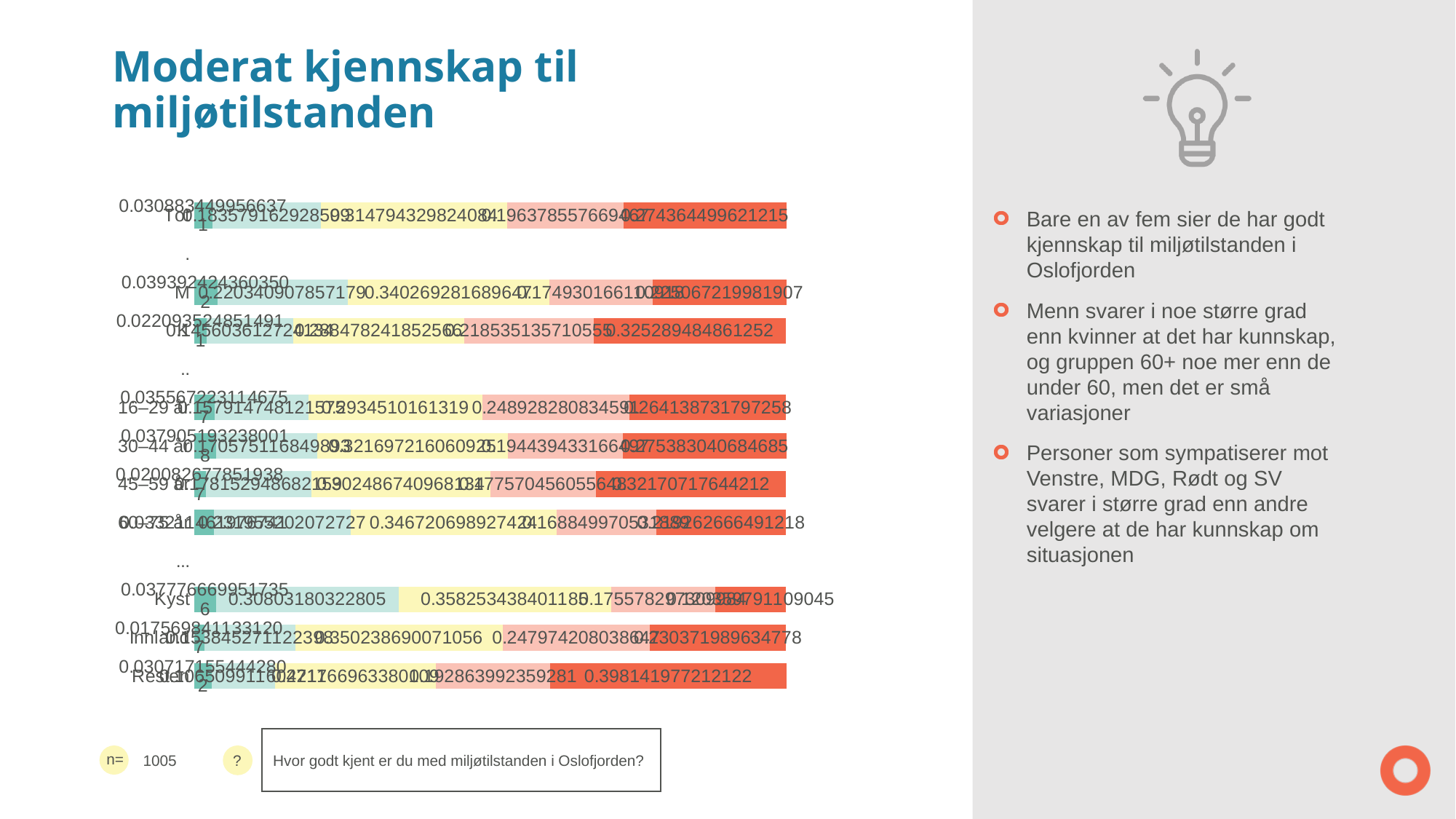
What kind of chart is shown on the slide? stacked bar chart Which category has the largest light teal segment? Kyst Which is larger, the red segment for Resten or the red segment for Kyst? Resten Which category has the largest red (rightmost) segment? Resten Which is larger, the light teal segment for Kyst or the light teal segment for Resten? Kyst What is the value of the red (rightmost) segment for Resten? 0.398141977212122 How many categories (rows) does the bar chart show? 10 What survey question is shown in the box below the chart? Hvor godt kjent er du med miljøtilstanden i Oslofjorden? What is the value of the light teal segment for Kyst? 0.30803180322805 What is the sample size (n) shown below the chart? 1005